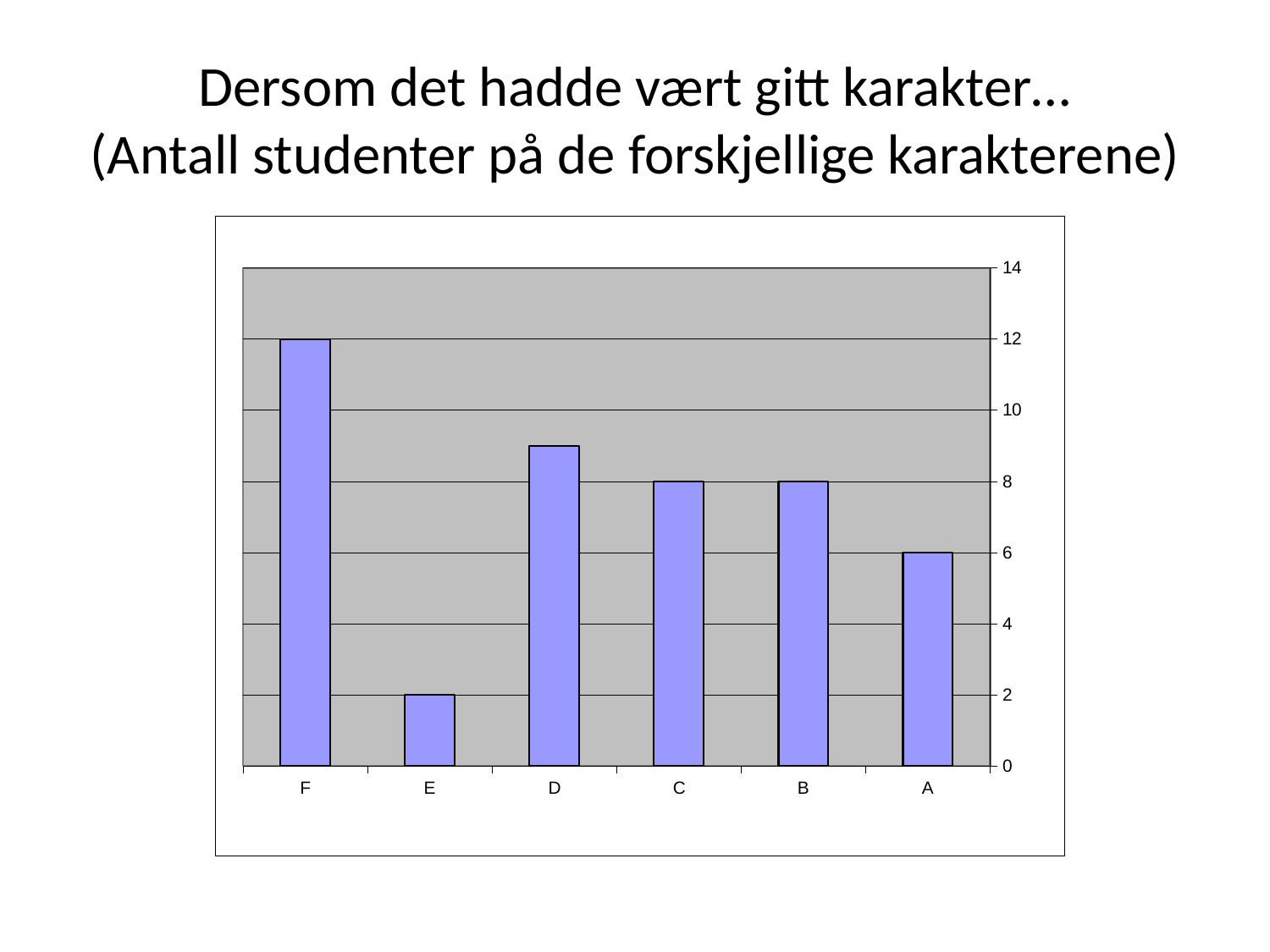
Which grade has the lowest number of students? E Is the value for grade D greater or less than 8? greater Which grade has the highest number of students? F What is the difference between the number of students with grade F and grade E? 10 How many students received grade A? 6 How many students received grade E? 2 What kind of chart is shown on the slide? bar chart How many students received grade C? 8 How many students received grade F? 12 What is the highest value shown on the vertical axis? 14 How many grade categories are shown on the x axis? 6 Which has more students, grade F or grade A? F